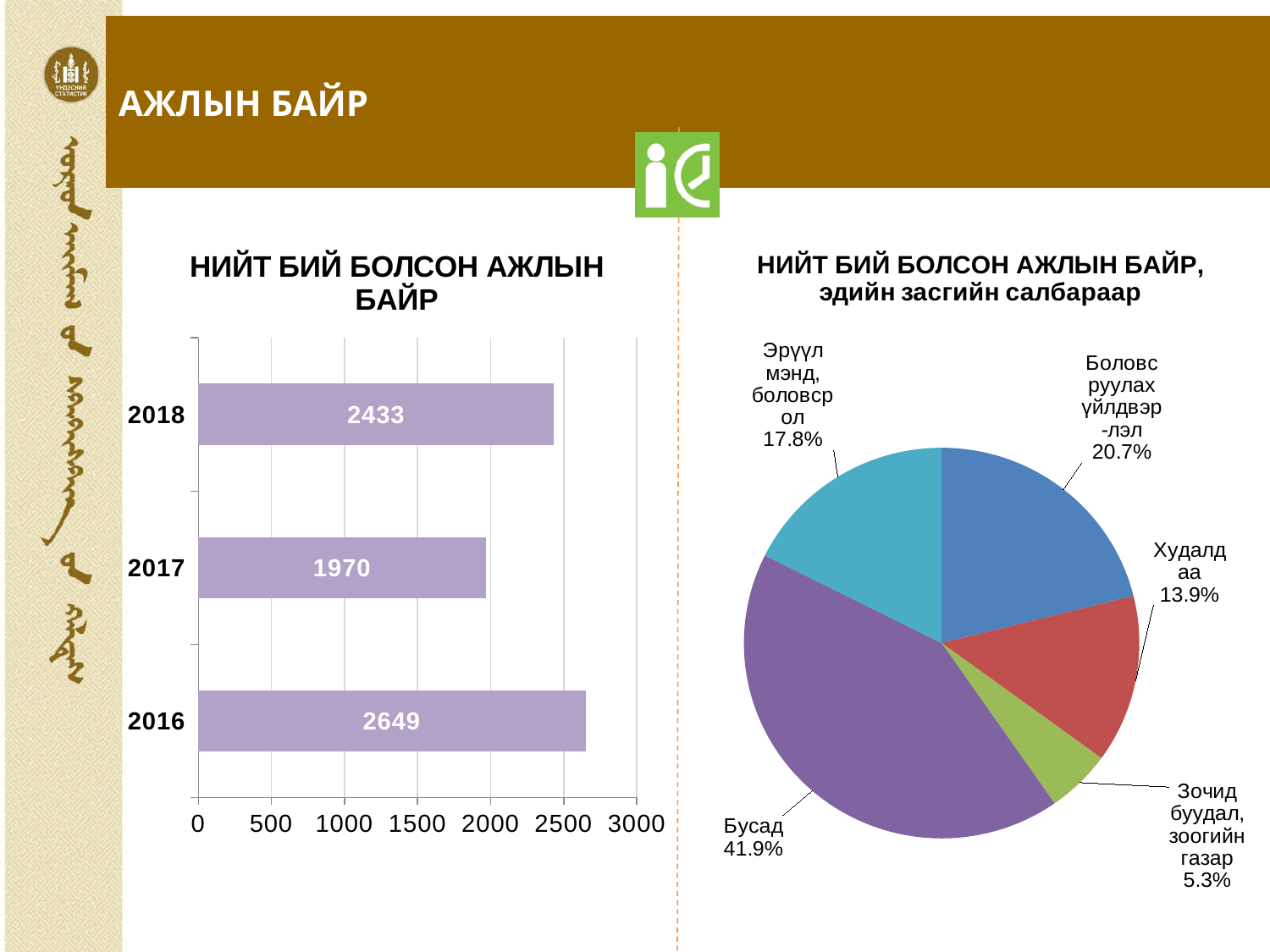
What kind of chart is the chart on the left of the slide? Bar chart In the pie chart on the right, what share does Бусад have? 41.9% In the pie chart on the right, how many slices are there? 5 In the pie chart on the right, what share does Худалдаа have? 13.9% In the bar chart on the left, which is larger, the value for 2018 or the value for 2017? 2018 In the bar chart on the left, how many years are shown? 3 In the bar chart on the left, which year has the highest value? 2016 In the bar chart on the left, what is the difference between the values for 2016 and 2017? 679 In the pie chart on the right, which slice is the smallest? Зочид буудал, зоогийн газар In the bar chart on the left, which year has the lowest value? 2017 In the bar chart on the left, what is the value for 2017? 1970 In the bar chart on the left, what is the value for 2018? 2433